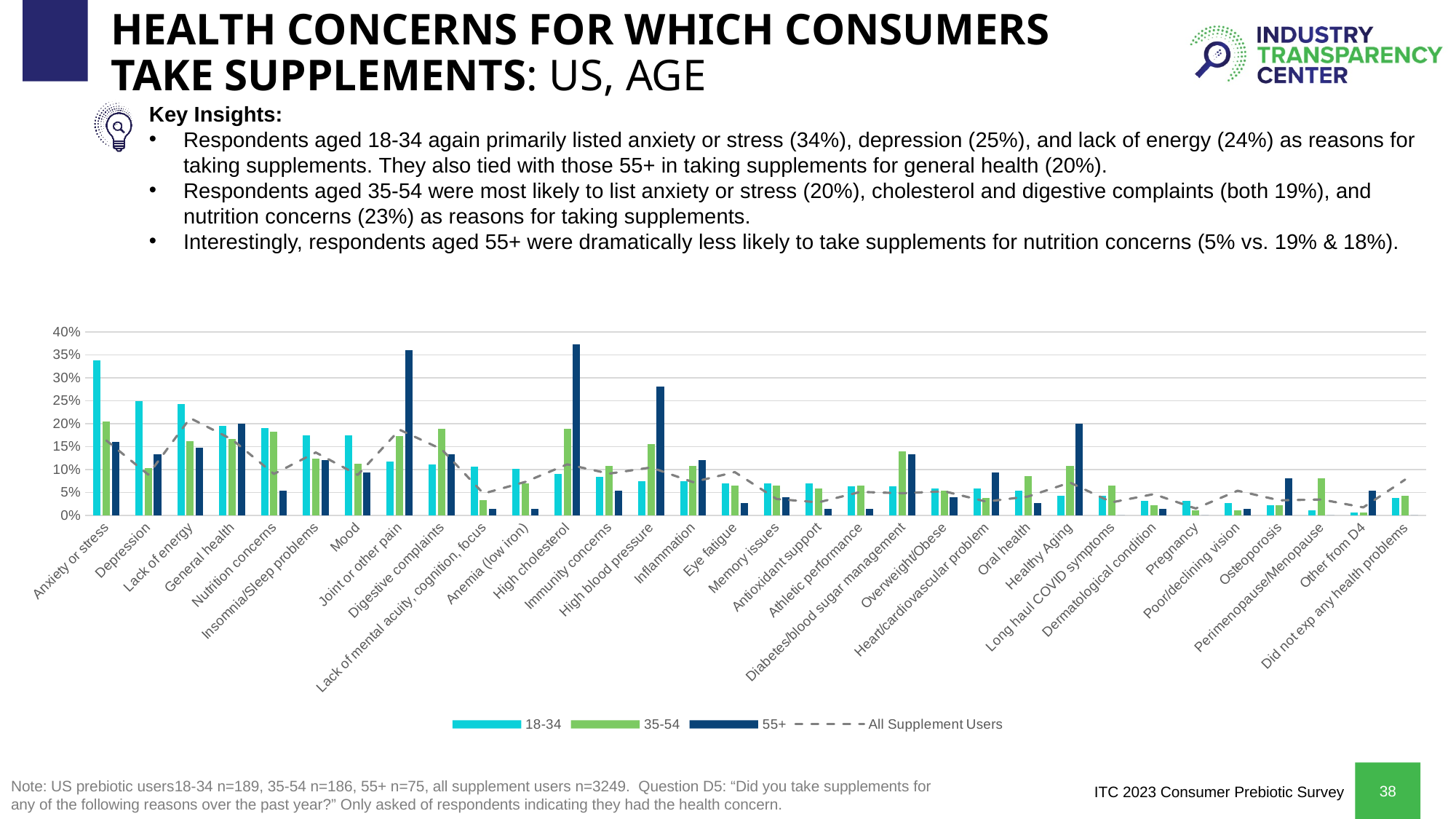
Which series in the legend is drawn as a dashed line rather than bars? All Supplement Users Is the 18-34 value for Anxiety or stress greater or less than 30%? greater Which health concern has the highest value for the 18-34 series? Anxiety or stress How many health concern categories are shown along the x axis of the chart? 32 For Anxiety or stress, which series has the larger value: 18-34 or 55+? 18-34 Is the 55+ value for Nutrition concerns greater or less than 10%? less Is the 55+ value for High cholesterol greater or less than 35%? greater For Healthy Aging, which series has the larger value: 18-34 or 55+? 55+ What type of chart is shown on the slide? combination bar and line chart How many series does the chart legend list? 4 What colour are the bars for the 35-54 series? green